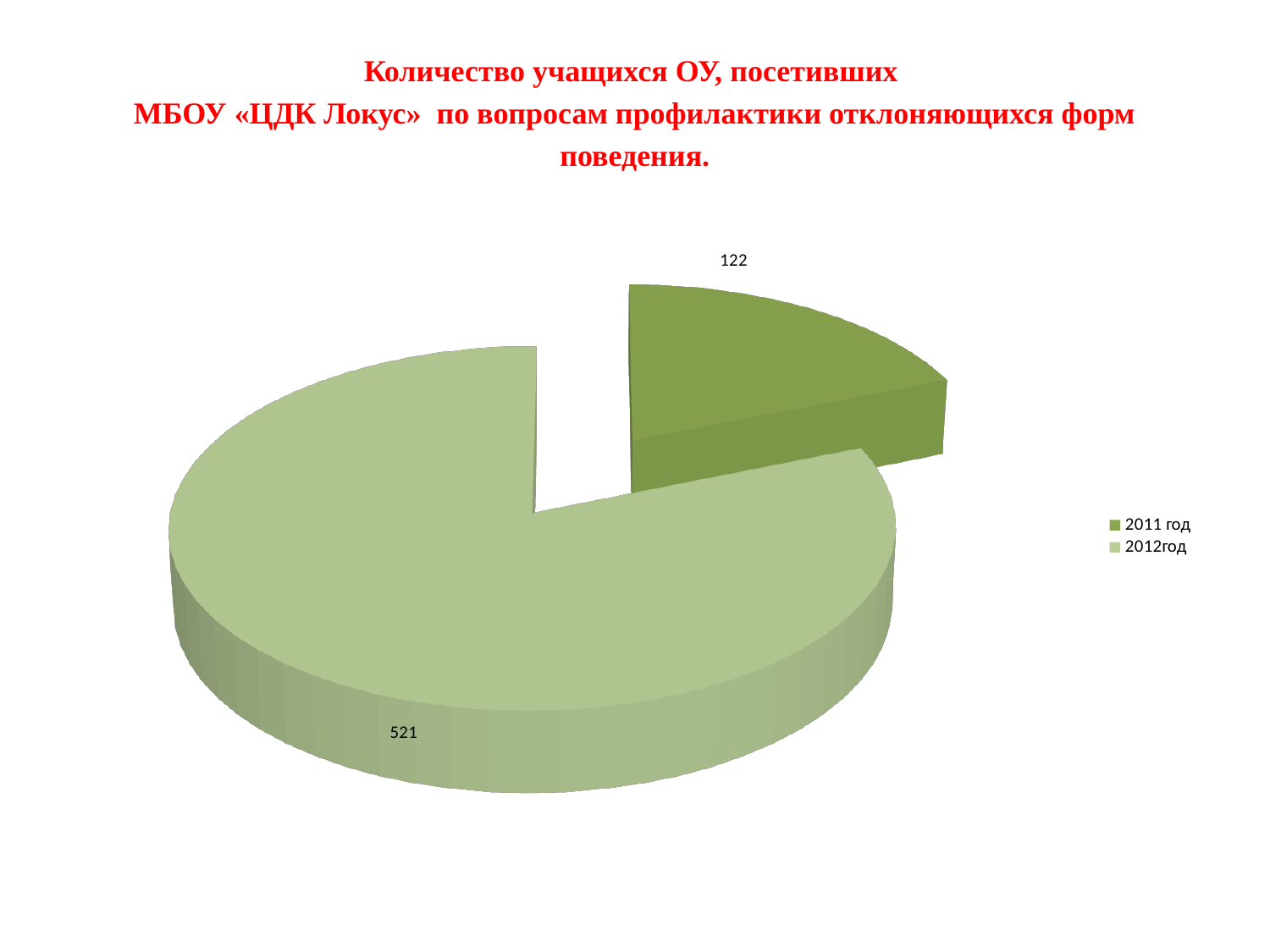
What is the value for 2011 год? 122 Which is larger, the value for 2011 год or the value for 2012год? 2012год How many slices does the pie chart have? 2 What type of chart is shown on the slide? pie chart What is the total of the two values shown in the pie chart? 643 Which legend entry is shown in the darker green colour? 2011 год To the nearest whole percent, what share of the pie does 2011 год represent? 19% What is the difference between the values for 2012год and 2011 год? 399 Which year has the smallest slice of the pie? 2011 год How many entries does the legend list? 2 What is the value for 2012год? 521 Which year has the largest slice of the pie? 2012год